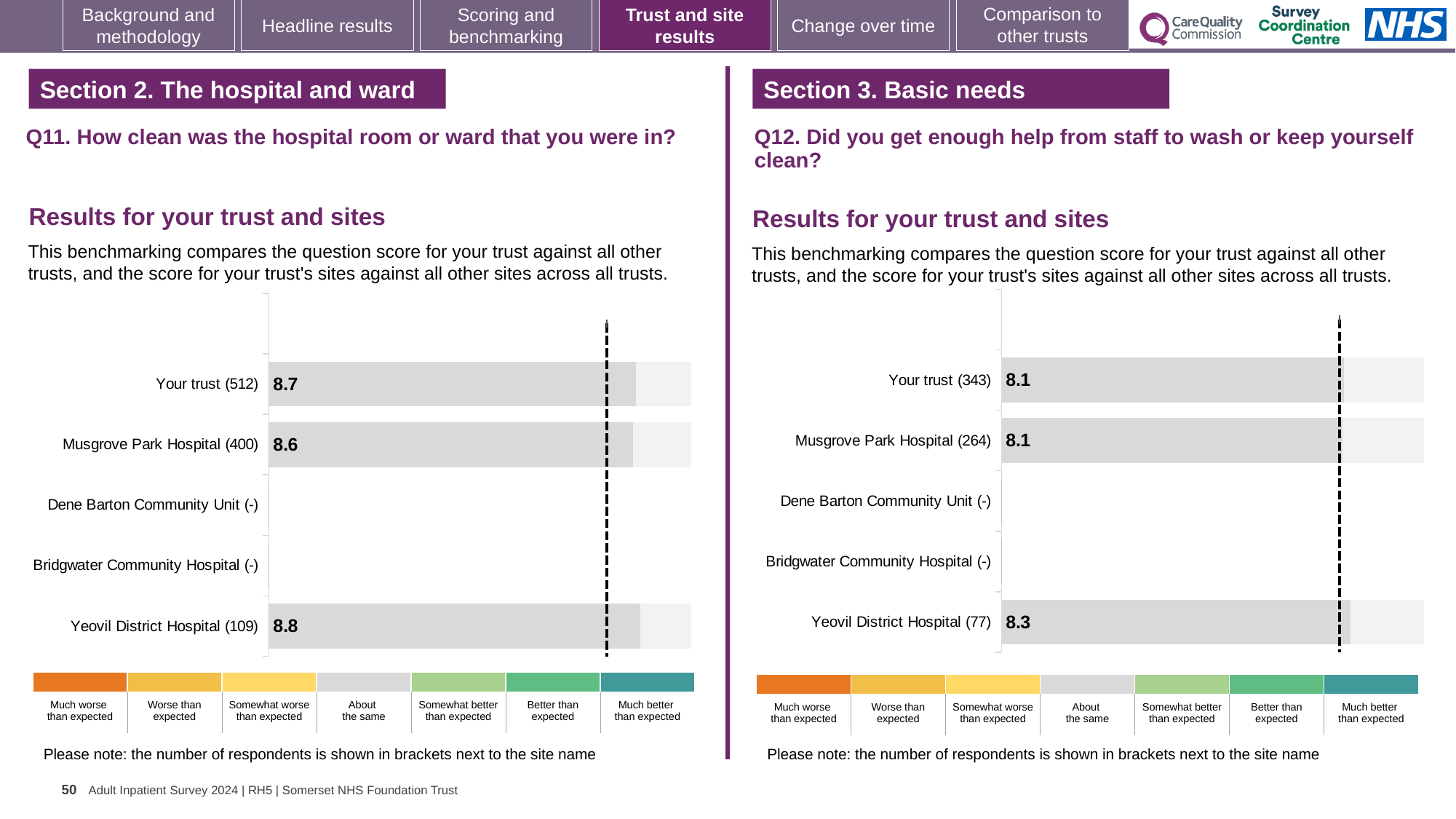
In the Q12 chart on the right, what is the difference between the scores for Yeovil District Hospital and Your trust? 0.2 In the Q12 chart on the right, what is the score for Yeovil District Hospital (77)? 8.3 In the Q11 chart on the left, which site has the highest score? Yeovil District Hospital (109) In the Q11 chart on the left, which is larger: the score for Your trust or the score for Musgrove Park Hospital? Your trust How many site rows (including Your trust) are listed in the Q11 chart on the left? 5 What type of chart is used for the Q12 results on the right? Bar chart In the Q11 chart on the left, how many respondents are shown in brackets for Yeovil District Hospital? 109 In the Q12 chart on the right, which site has the highest score? Yeovil District Hospital (77) In the Q11 chart on the left, what is the score for Musgrove Park Hospital (400)? 8.6 In the Q11 chart on the left, what is the score for Your trust (512)? 8.7 In the Q12 chart on the right, what is the score for Your trust (343)? 8.1 In the Q11 chart on the left, what is the difference between the scores for Yeovil District Hospital and Musgrove Park Hospital? 0.2